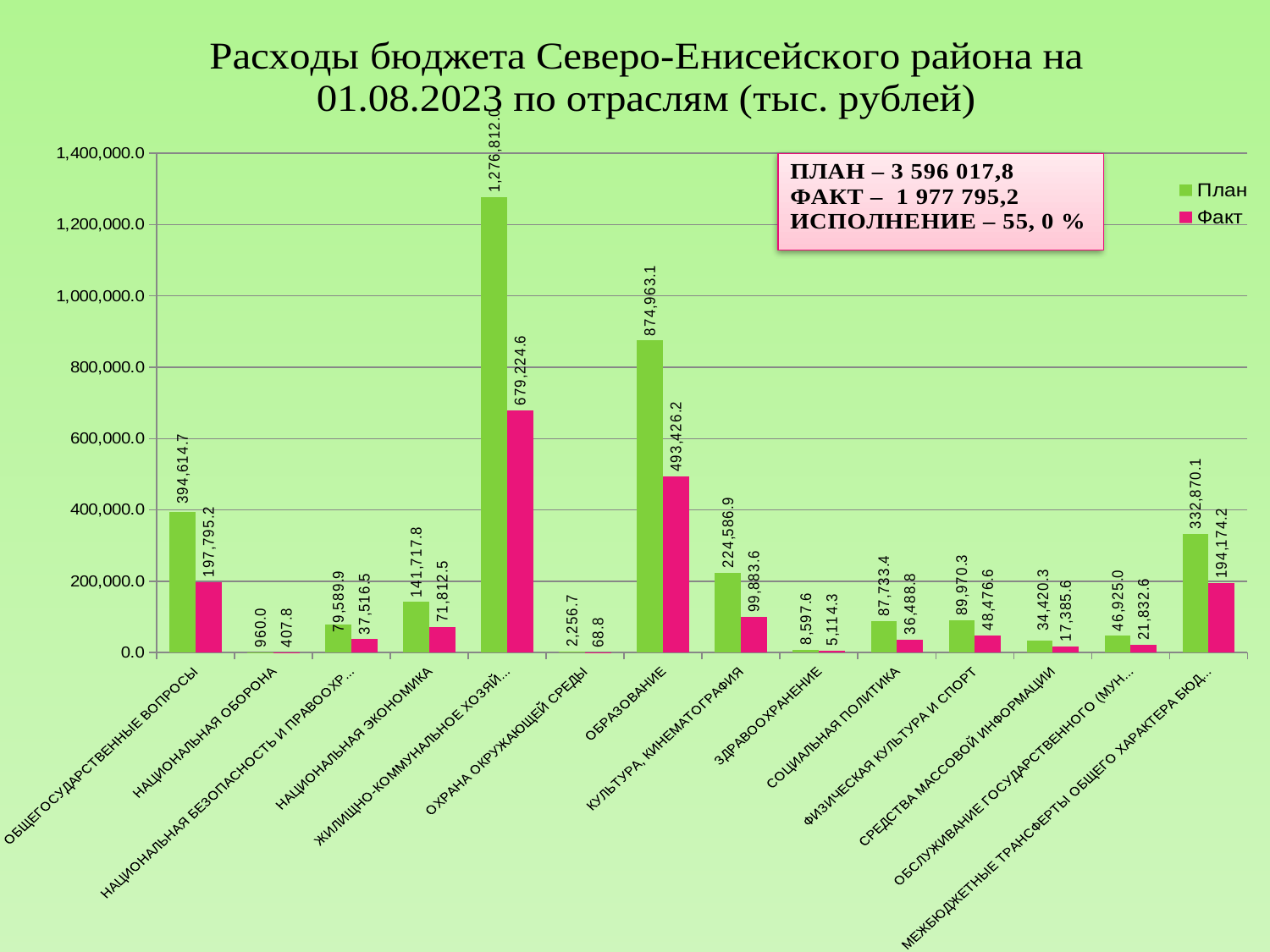
Which category has the highest План value? ЖИЛИЩНО-КОММУНАЛЬНОЕ ХОЗЯЙ... How many series does the legend list? 2 Which category has the lowest Факт value? ОХРАНА ОКРУЖАЮЩЕЙ СРЕДЫ What is the Факт value for КУЛЬТУРА, КИНЕМАТОГРАФИЯ? 99,883.6 Is the План value for МЕЖБЮДЖЕТНЫЕ ТРАНСФЕРТЫ ОБЩЕГО ХАРАКТЕРА БЮД... greater or less than 200,000.0? greater What is the План value for ФИЗИЧЕСКАЯ КУЛЬТУРА И СПОРТ? 89,970.3 How many categories are shown on the x axis? 14 What is the План value for ОБРАЗОВАНИЕ? 874,963.1 What is the Факт value for ОБЩЕГОСУДАРСТВЕННЫЕ ВОПРОСЫ? 197,795.2 What is the difference between the План and Факт values for ОБРАЗОВАНИЕ? 381,536.9 Which is larger: the Факт value for ОБРАЗОВАНИЕ or the Факт value for ЖИЛИЩНО-КОММУНАЛЬНОЕ ХОЗЯЙ...? ЖИЛИЩНО-КОММУНАЛЬНОЕ ХОЗЯЙ... What kind of chart is shown on the slide? bar chart